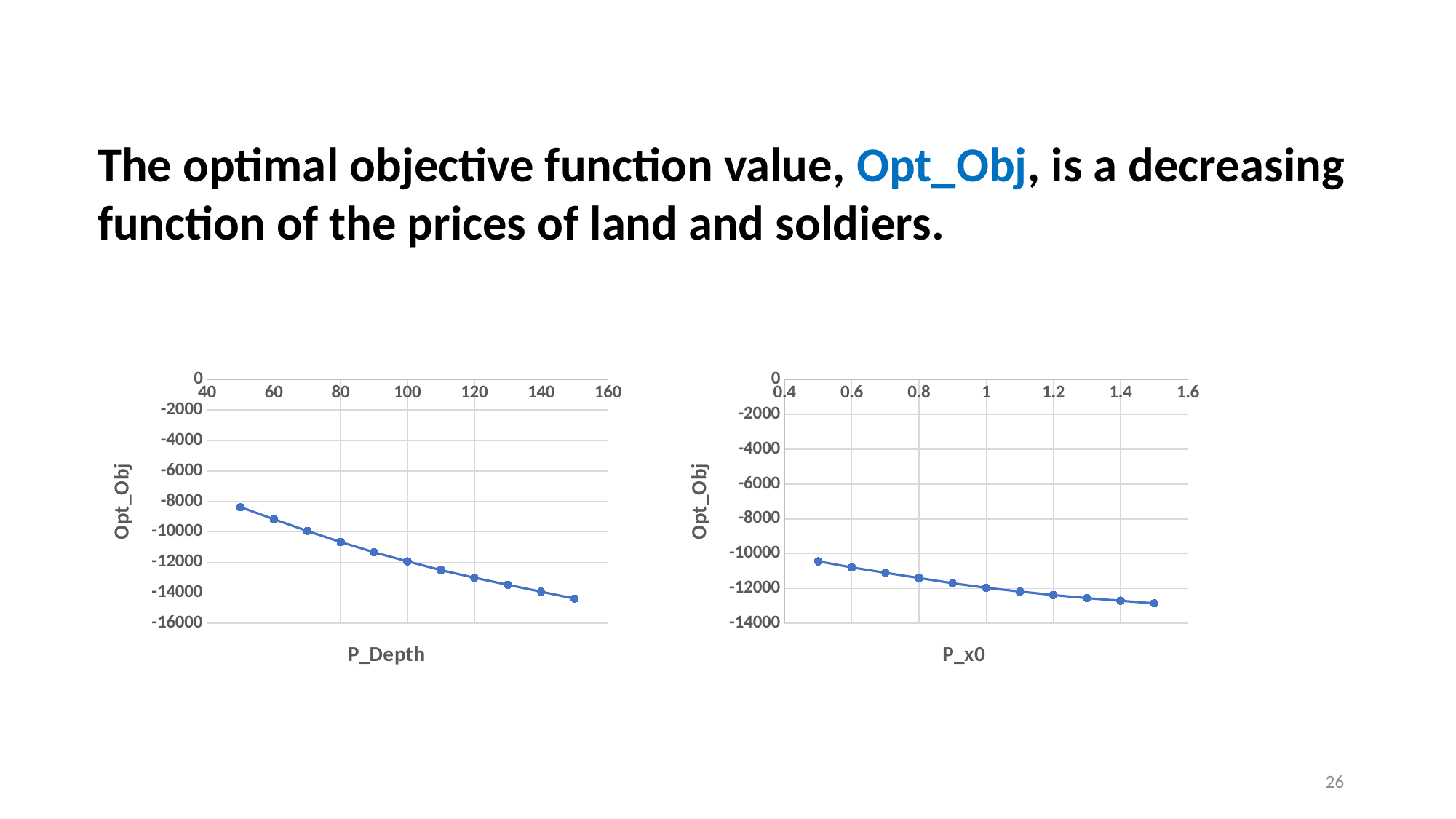
What is the y-axis title of the right chart? Opt_Obj In the right chart (P_x0), is the Opt_Obj value at P_x0 = 0.5 greater or less than -10000? less In the left chart (P_Depth), do the Opt_Obj values rise or fall as P_Depth increases? fall In the left chart (P_Depth), is the Opt_Obj value at P_Depth = 150 greater or less than -14000? less In the left chart (P_Depth), which P_Depth value has the lowest Opt_Obj? 150 How many data points are plotted in the right chart (P_x0)? 11 What kind of chart is the left chart with x axis P_Depth? line chart In the right chart (P_x0), do the Opt_Obj values rise or fall as P_x0 increases? fall In the left chart (P_Depth), is the Opt_Obj value at P_Depth = 120 greater or less than -12000? less How many data points are plotted in the left chart (P_Depth)? 11